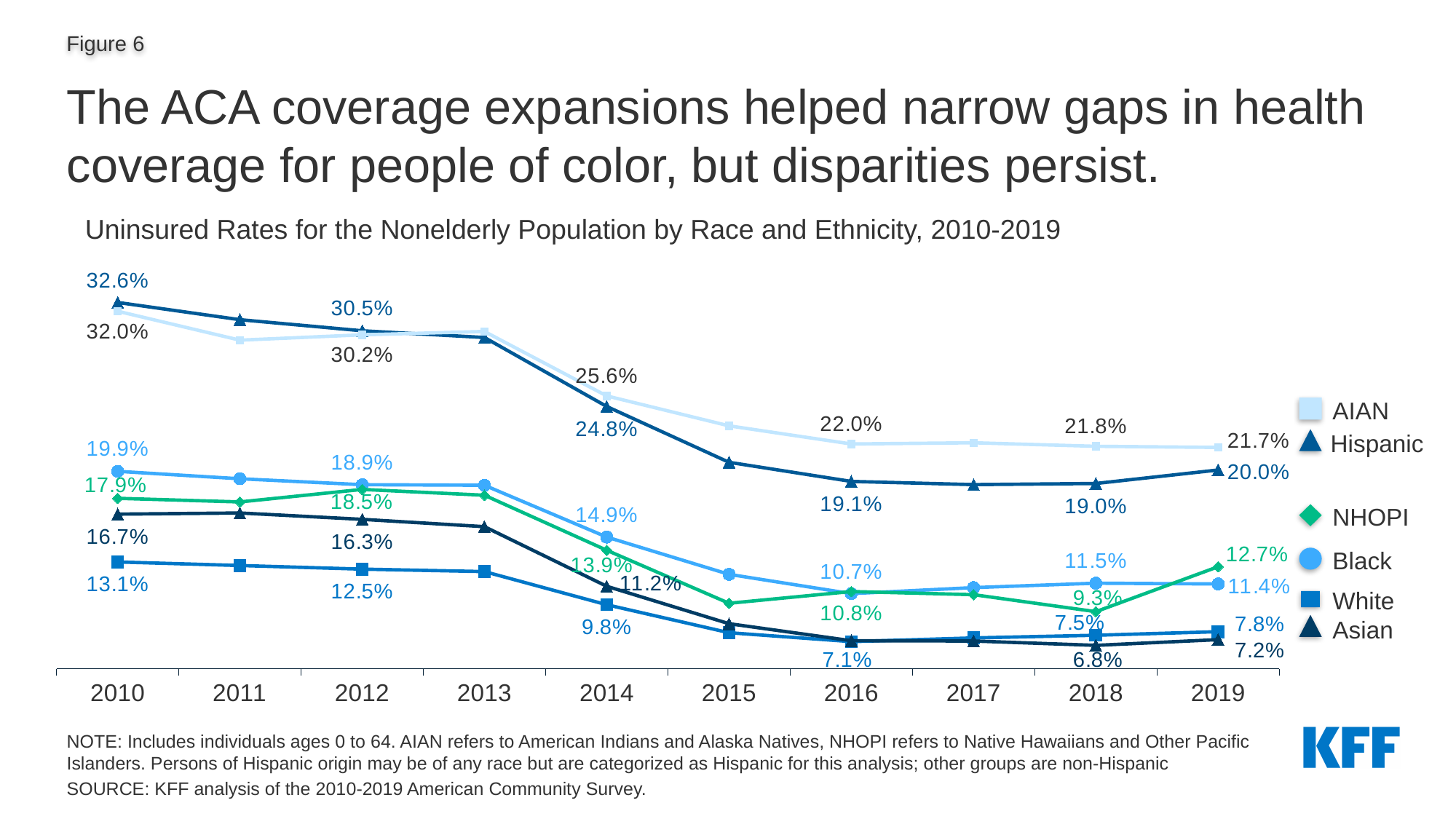
Which group had the highest uninsured rate in 2019? AIAN What was the uninsured rate for AIAN people in 2019? 21.7% What was the uninsured rate for NHOPI people in 2018? 9.3% Which group had the lowest uninsured rate in 2018? Asian What was the uninsured rate for White people in 2014? 9.8% How many years are shown on the x axis? 10 Did the uninsured rate for Black people rise or fall from 2010 to 2016? Fall What kind of chart is this? Line chart What was the uninsured rate for Hispanic people in 2010? 32.6% What is the difference between the Hispanic uninsured rate in 2010 and in 2019? 12.6 percentage points How many series does the legend list? 6 In 2019, which group had a higher uninsured rate, NHOPI or Black? NHOPI